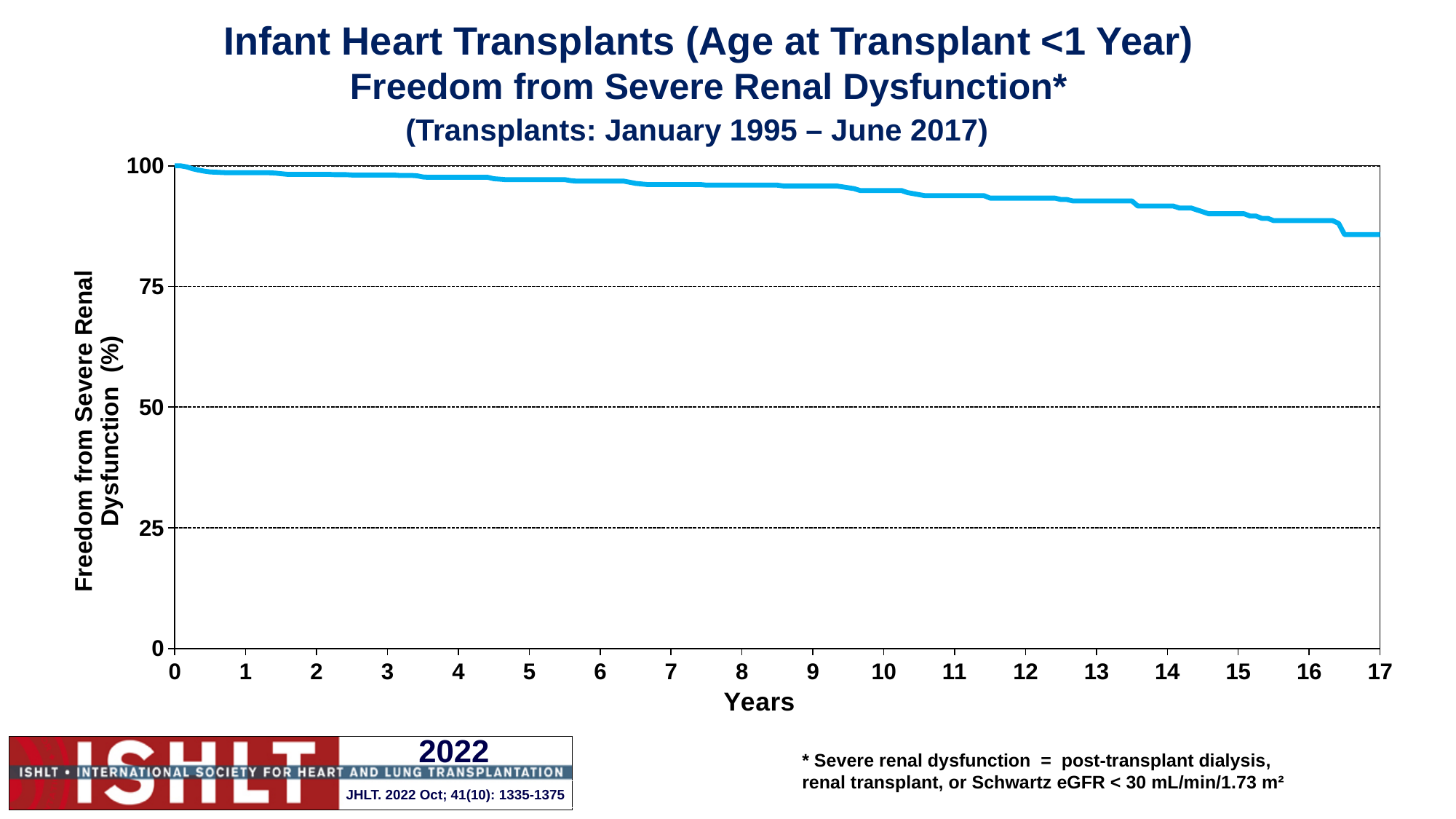
Which is larger, the freedom from severe renal dysfunction at year 2 or at year 16? year 2 Is the freedom from severe renal dysfunction at year 10 greater or less than 75? greater At which year on the x axis is the freedom from severe renal dysfunction highest? 0 Is the freedom from severe renal dysfunction at year 17 greater or less than 75? greater At which year on the x axis is the freedom from severe renal dysfunction lowest? 17 Is the freedom from severe renal dysfunction at year 17 greater or less than 100? less What kind of chart is shown on the slide? line chart What is the freedom from severe renal dysfunction at year 0? 100 What is the label of the x axis? Years What is the highest value shown on the y axis? 100 Does the freedom from severe renal dysfunction rise or fall as years since transplant increase? fall